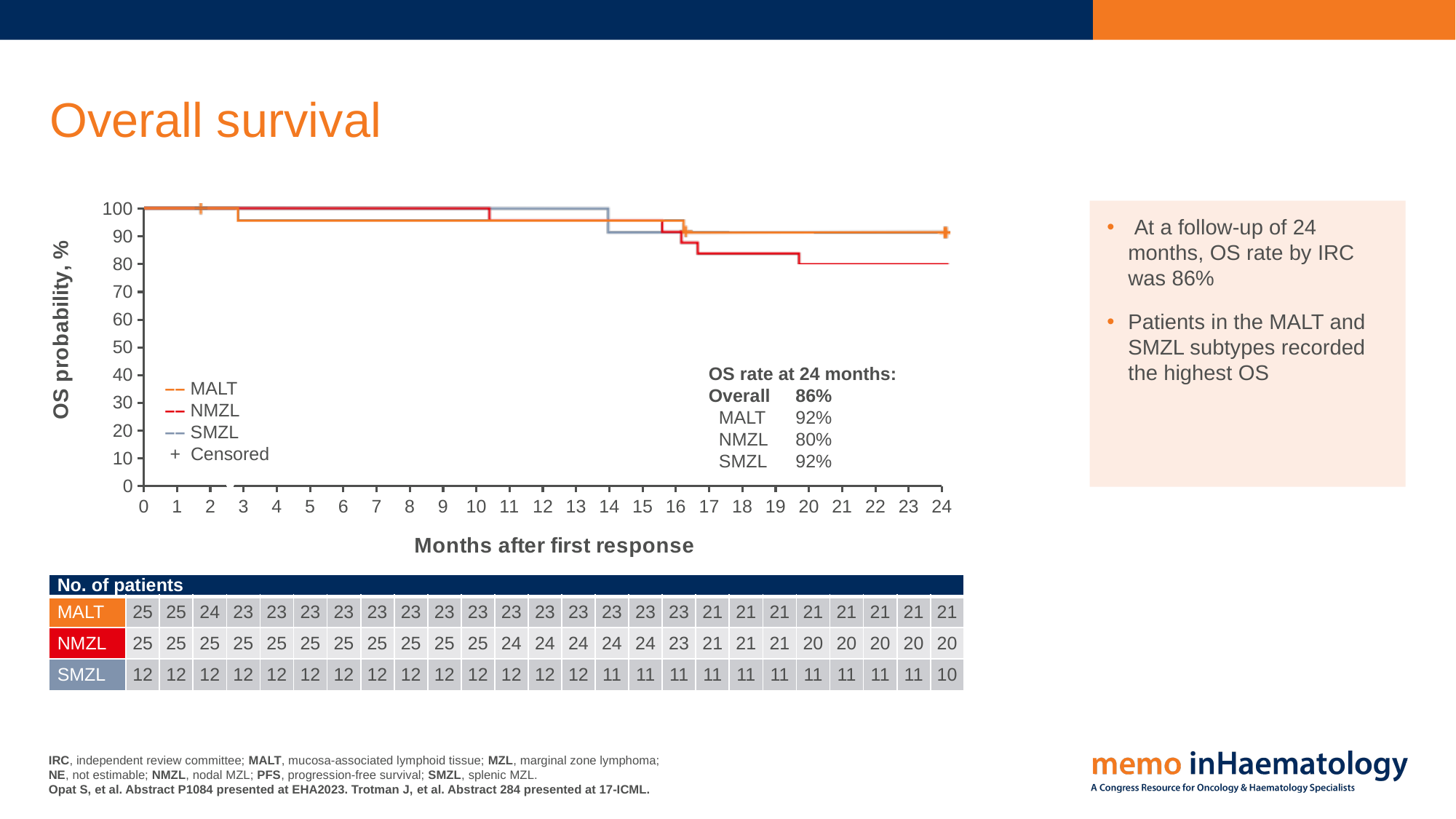
What is the difference between the OS rate at 24 months for MALT and for NMZL? 12% What kind of chart is shown on the slide? Line chart (Kaplan-Meier survival curve) In the No. of patients table, how many SMZL patients are listed at 24 months? 10 Which has the higher OS rate at 24 months, NMZL or SMZL? SMZL What is the OS rate at 24 months for NMZL? 80% Which subtype has the lowest OS rate at 24 months? NMZL How many lymphoma subtype curves does the legend list? 3 What is the title of the x axis? Months after first response Do the survival curves rise or fall as months after first response increase? Fall What is the OS rate at 24 months for MALT? 92% What is the overall OS rate at 24 months shown on the chart? 86% Is the NMZL curve at 20 months greater or less than 90? less